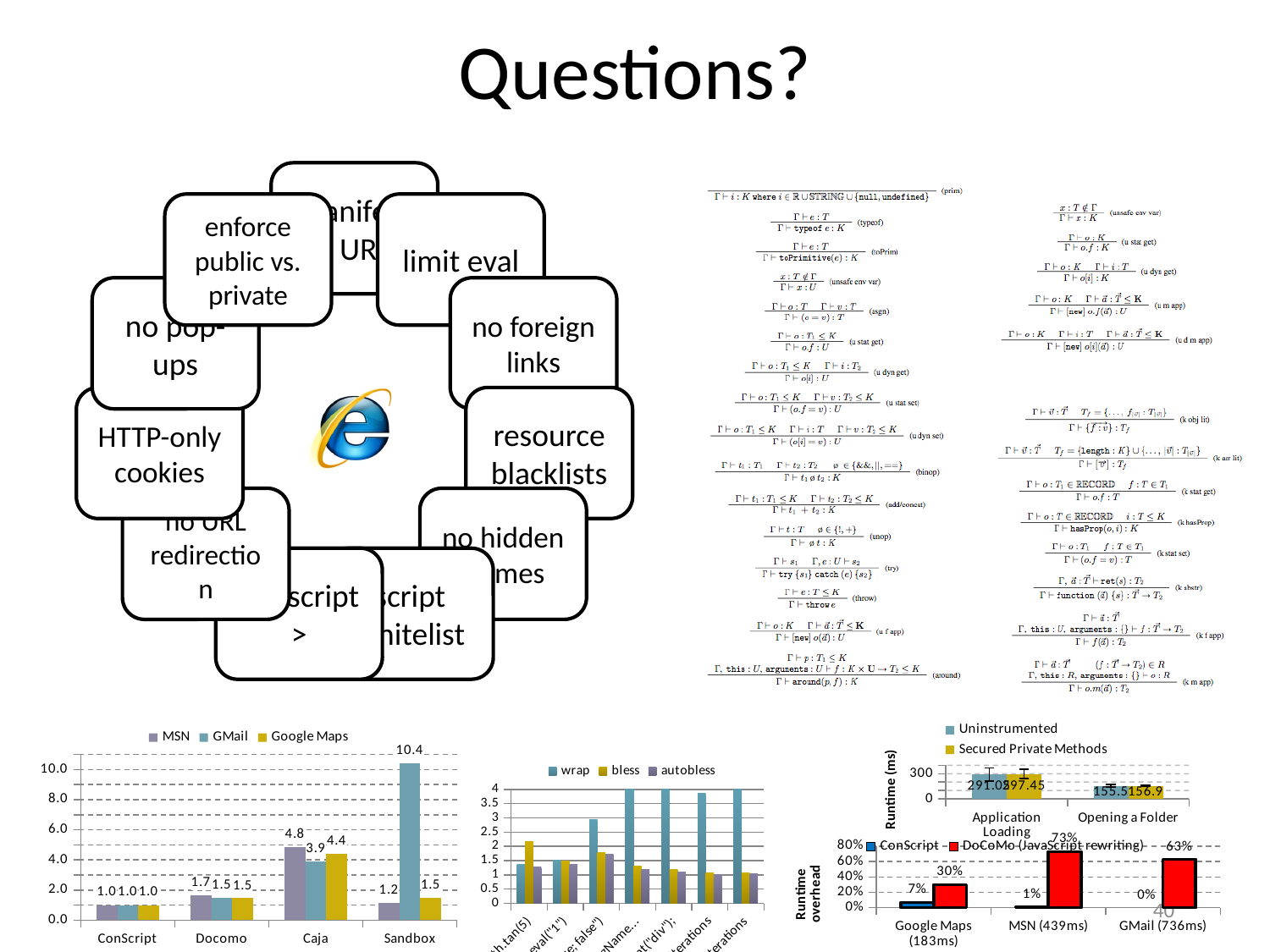
What kind of chart is the bottom-middle chart with the wrap, bless and autobless legend? bar chart In the Runtime overhead chart at the bottom right, which is larger for Google Maps (183ms): ConScript or DoCoMo (JavaScript rewriting)? DoCoMo (JavaScript rewriting) In the bottom-left chart with the MSN, GMail and Google Maps legend, is the MSN value for Caja greater or less than 4.0? greater In the bottom-left chart with the MSN, GMail and Google Maps legend, what is the difference between the Google Maps values for Caja and Docomo? 2.9 How many series does the legend of the bottom-middle chart (wrap, bless, autobless) list? 3 In the Runtime (ms) chart at the bottom right, what is the Secured Private Methods value for Opening a Folder? 156.9 In the bottom-left chart with the MSN, GMail and Google Maps legend, how many categories are shown on the x axis? 4 In the Runtime (ms) chart at the bottom right, what is the Uninstrumented value for Application Loading? 291.05 In the bottom-left chart with the MSN, GMail and Google Maps legend, what is the MSN value for Caja? 4.8 In the bottom-left chart with the MSN, GMail and Google Maps legend, which category has the highest GMail value? Sandbox In the bottom-left chart with the MSN, GMail and Google Maps legend, what is the GMail value for Sandbox? 10.4 In the Runtime overhead chart at the bottom right, what is the DoCoMo (JavaScript rewriting) value for MSN (439ms)? 73%